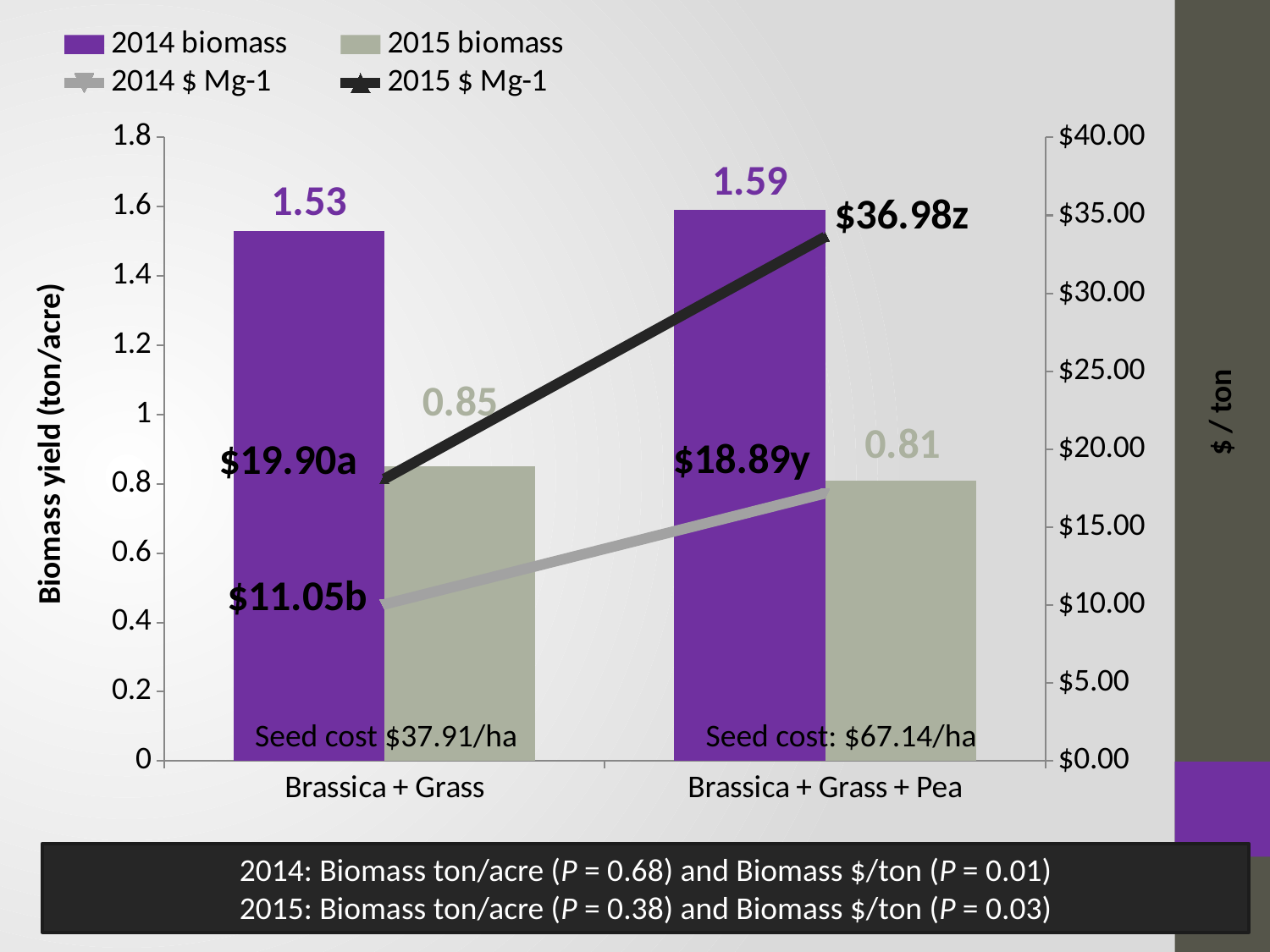
Which category has the larger 2015 biomass value, Brassica + Grass or Brassica + Grass + Pea? Brassica + Grass What is the 2014 biomass value for Brassica + Grass? 1.53 What is the 2015 $ Mg-1 data label for Brassica + Grass + Pea? $36.98z What kind of chart is this? Combination bar and line chart What is the title of the left vertical axis? Biomass yield (ton/acre) Which category has the higher 2014 biomass value? Brassica + Grass + Pea What is the 2015 biomass value for Brassica + Grass + Pea? 0.81 How many series does the legend list? 4 How many categories are shown on the x axis? 2 Does the 2015 $ Mg-1 line rise or fall from Brassica + Grass to Brassica + Grass + Pea? Rises What is the 2014 $ Mg-1 data label for Brassica + Grass? $11.05b What is the difference between the 2014 biomass values for Brassica + Grass + Pea and Brassica + Grass? 0.06